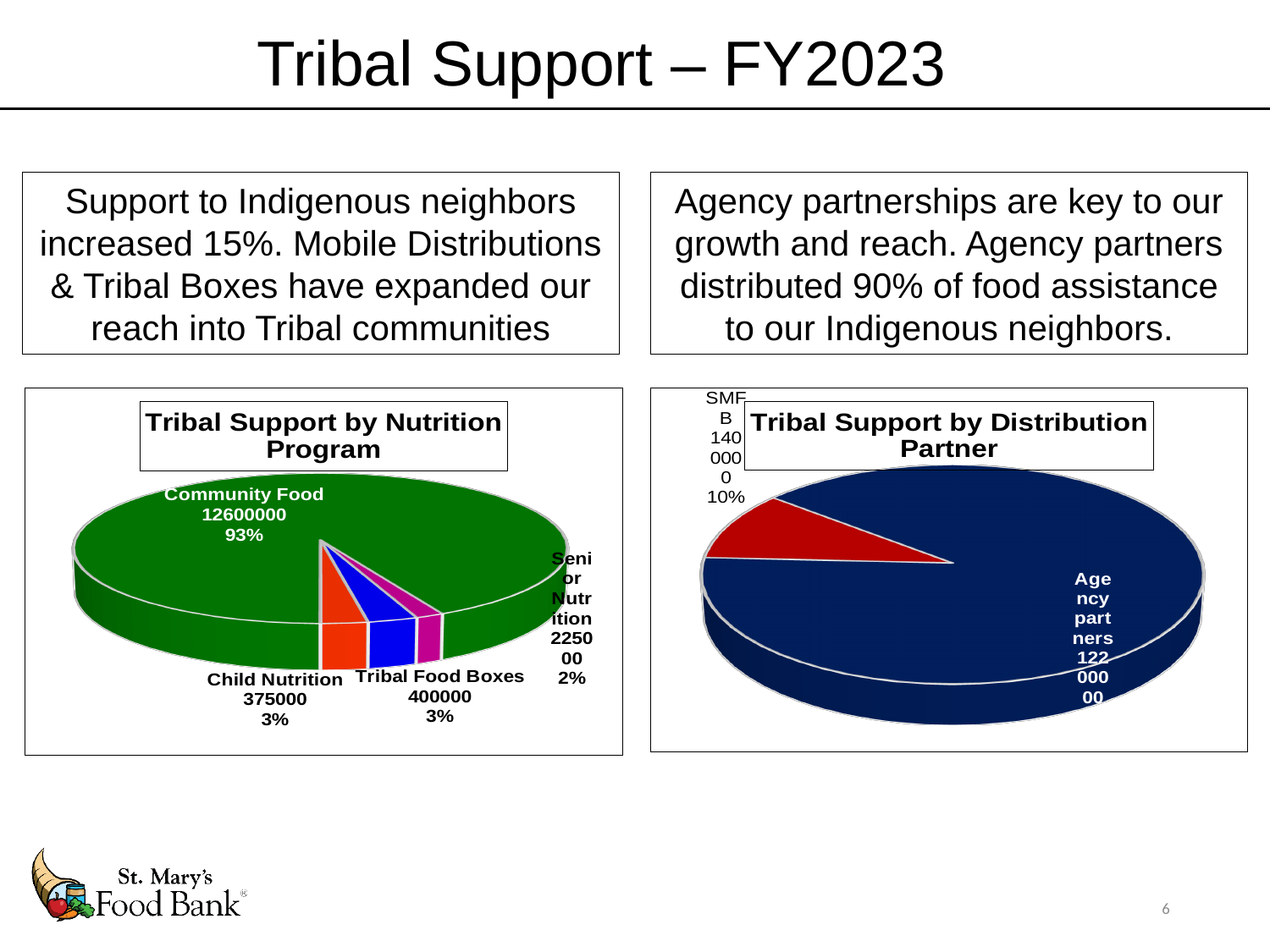
In the 'Tribal Support by Nutrition Program' chart, which program has the smallest slice? Senior Nutrition In the 'Tribal Support by Distribution Partner' chart, what share of the pie is SMFB? 10% In the 'Tribal Support by Nutrition Program' chart, what value is shown for Community Food? 12600000 In the 'Tribal Support by Nutrition Program' chart, what value is shown for Tribal Food Boxes? 400000 In the 'Tribal Support by Nutrition Program' chart, what is the difference between the Tribal Food Boxes value and the Child Nutrition value? 25000 In the 'Tribal Support by Nutrition Program' chart, what share of the pie is Community Food? 93% In the 'Tribal Support by Nutrition Program' chart, which program has the largest slice? Community Food In the 'Tribal Support by Distribution Partner' chart, which partner has the larger slice, SMFB or Agency partners? Agency partners In the 'Tribal Support by Nutrition Program' chart, what share of the pie is Senior Nutrition? 2% What type of chart is 'Tribal Support by Nutrition Program'? pie chart In the 'Tribal Support by Nutrition Program' chart, how many slices does the pie have? 4 In the 'Tribal Support by Nutrition Program' chart, what value is shown for Child Nutrition? 375000